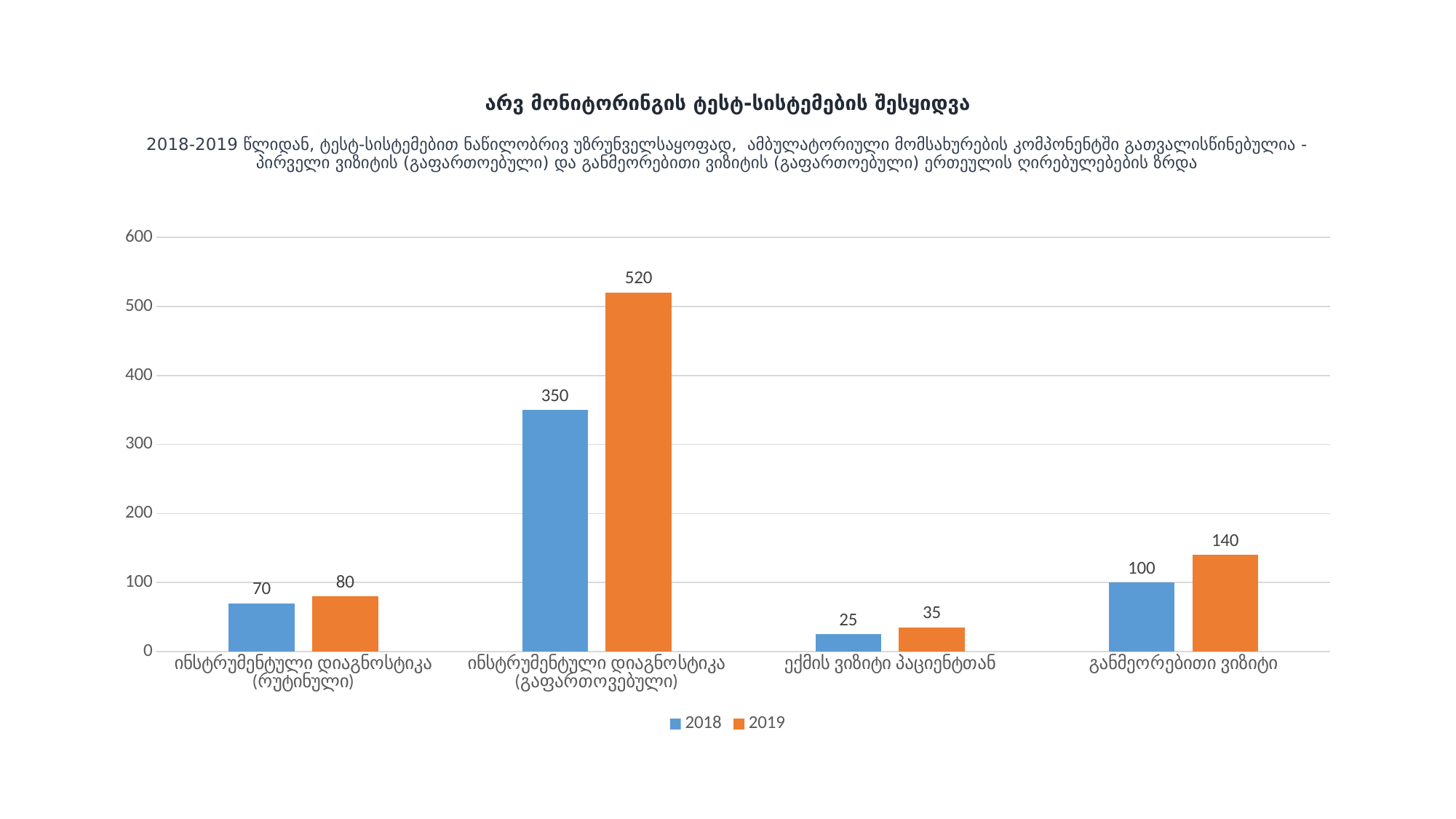
What is the difference between the 2019 and 2018 values for ინსტრუმენტული დიაგნოსტიკა (გაფართოვებული)? 170 Which category has the highest 2019 value? ინსტრუმენტული დიაგნოსტიკა (გაფართოვებული) What is the difference between the 2019 and 2018 values for განმეორებითი ვიზიტი? 40 What is the 2019 value for ინსტრუმენტული დიაგნოსტიკა (გაფართოვებული)? 520 Which series is shown in orange? 2019 Which is larger: the 2019 value for ინსტრუმენტული დიაგნოსტიკა (რუტინული) or the 2019 value for განმეორებითი ვიზიტი? განმეორებითი ვიზიტი What is the 2018 value for ექიმის ვიზიტი პაციენტთან? 25 What kind of chart is shown on the slide? Bar chart How many categories are shown on the x axis? 4 Which category has the lowest 2018 value? ექმის ვიზიტი პაციენტთან How many series does the legend list? 2 What is the 2018 value for განმეორებითი ვიზიტი? 100